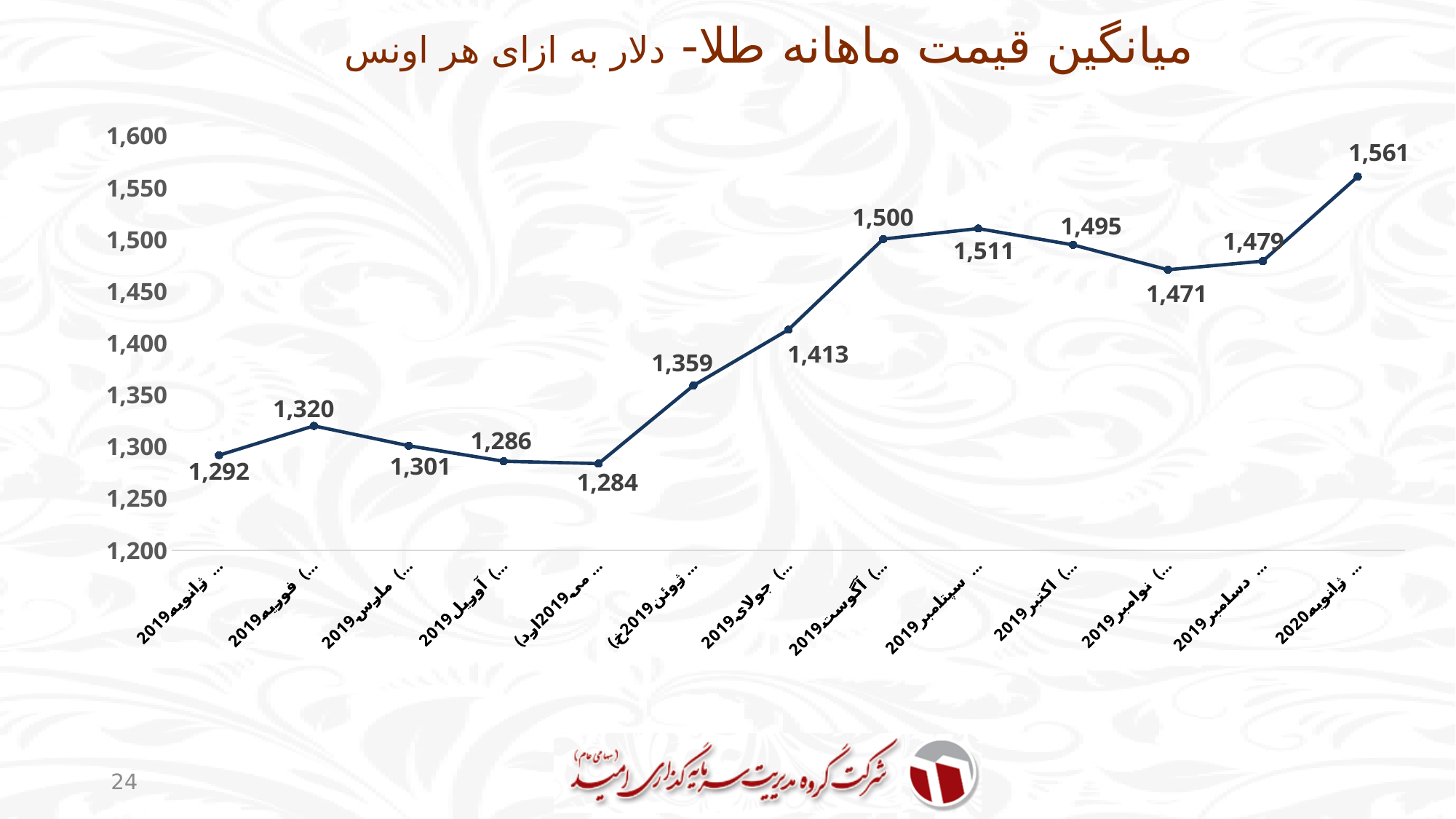
Which is higher, the gold price in February 2019 (فوریه 2019) or June 2019 (ژوئن 2019)? June 2019 (ژوئن 2019) What type of chart is shown on the slide? line chart Which month has the highest average gold price? January 2020 (ژانویه 2020) What is the average gold price for January 2020 (ژانویه 2020)? 1,561 Which month has the lowest average gold price? May 2019 (می 2019) Does the gold price generally rise or fall from May 2019 to September 2019? rise What is the title of the chart? میانگین قیمت ماهانه طلا- دلار به ازای هر اونس What is the difference between the gold price in January 2020 and January 2019? 269 How many data points are plotted on the line? 13 What is the average gold price for January 2019 (ژانویه 2019)? 1,292 What is the average gold price for August 2019 (آگوست 2019)? 1,500 What is the difference between the gold price in September 2019 (سپتامبر 2019) and October 2019 (اکتبر 2019)? 16